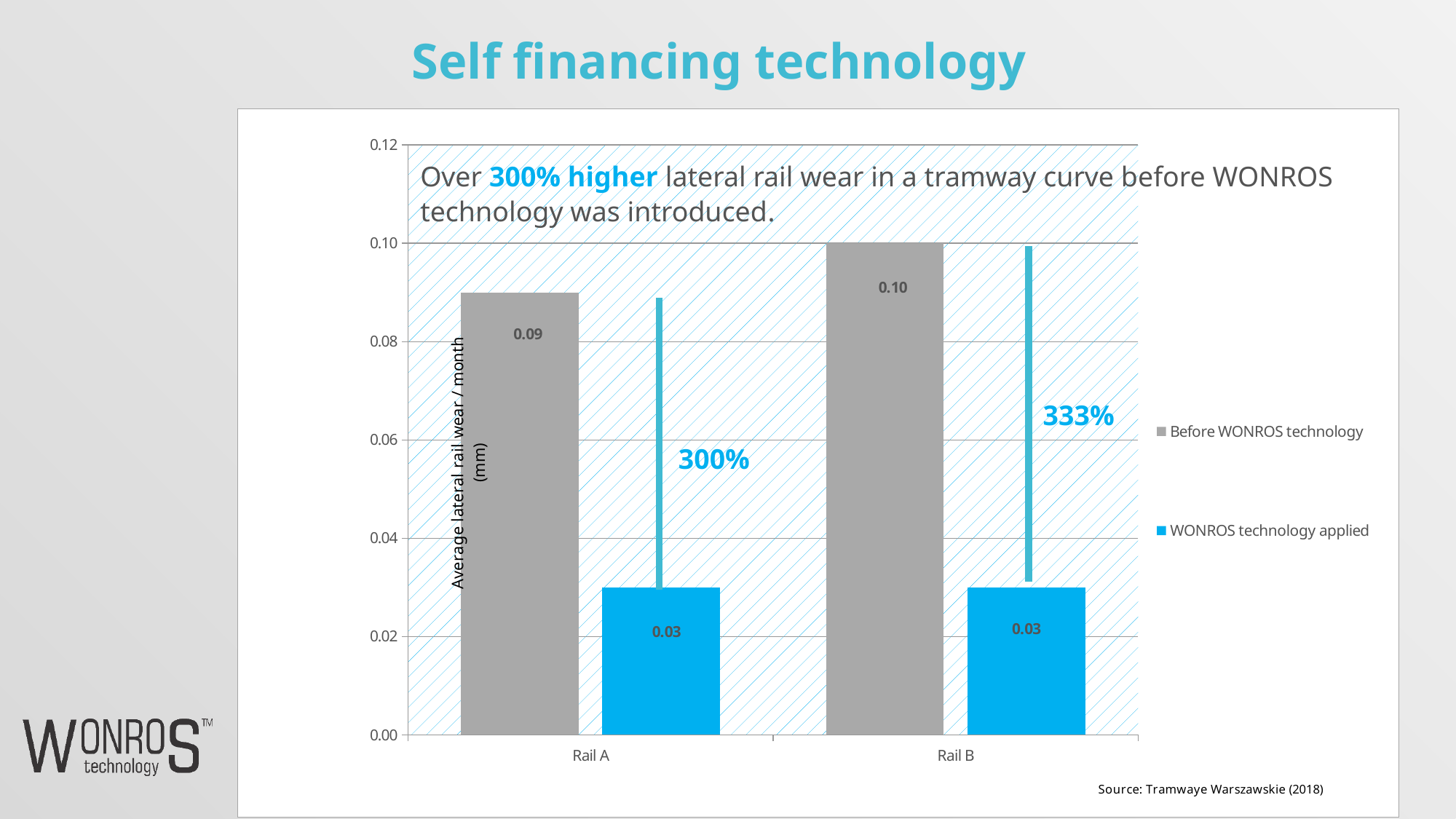
How many categories are shown on the x axis? 2 What is the value for Rail B in the 'Before WONROS technology' series? 0.10 For Rail A, which series has the larger value: 'Before WONROS technology' or 'WONROS technology applied'? Before WONROS technology What is the difference between the 'Before WONROS technology' and 'WONROS technology applied' values for Rail A? 0.06 What is the label of the vertical axis? Average lateral rail wear / month (mm) What is the value for Rail A in the 'WONROS technology applied' series? 0.03 What kind of chart is shown on the slide? Bar chart What is the difference between the 'Before WONROS technology' and 'WONROS technology applied' values for Rail B? 0.07 Which category has the highest value in the 'Before WONROS technology' series? Rail B How many series does the legend list? 2 What is the value for Rail A in the 'Before WONROS technology' series? 0.09 What is the value for Rail B in the 'WONROS technology applied' series? 0.03